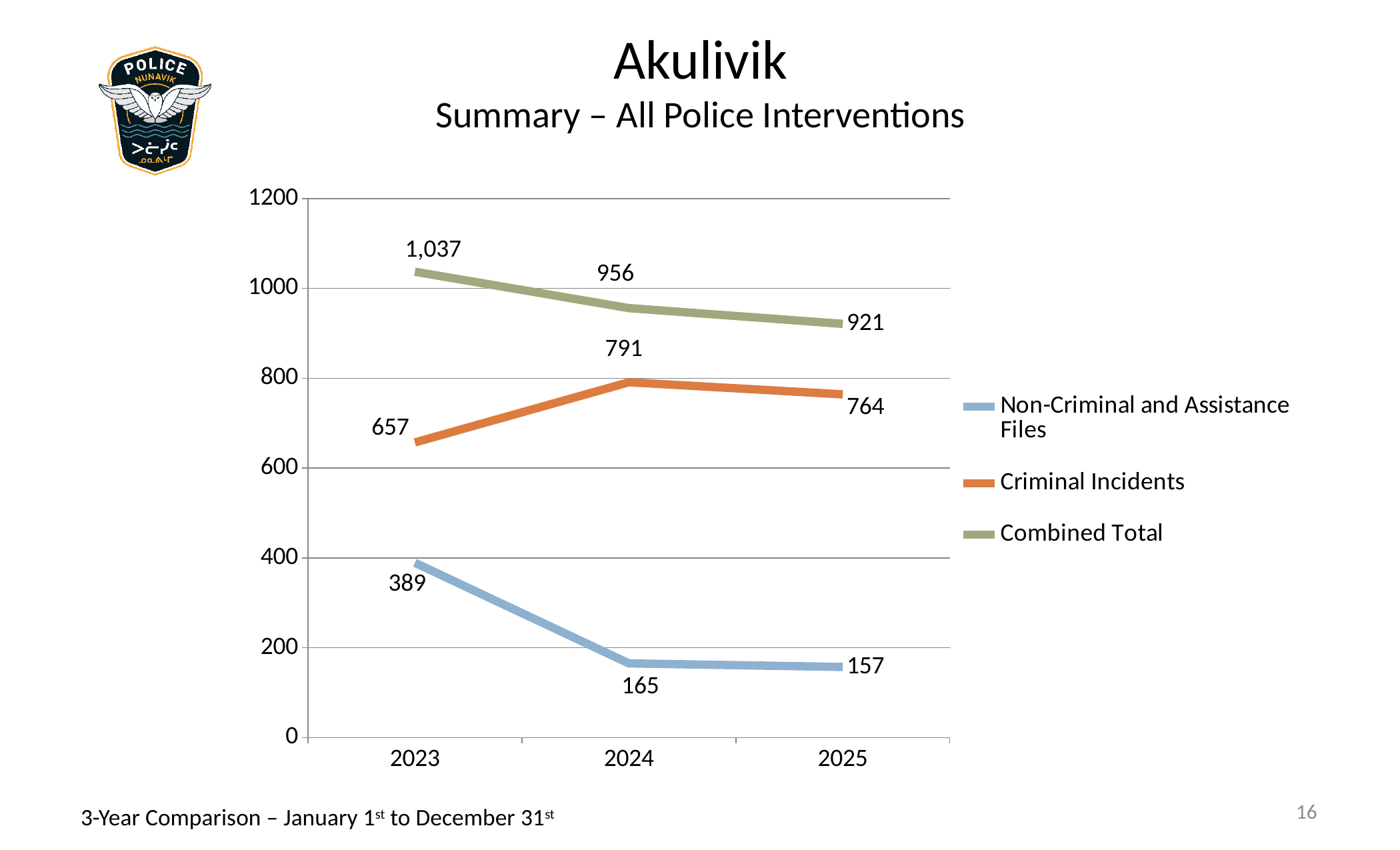
How many series does the legend list? 3 What is the value for Criminal Incidents in 2024? 791 What is the value for Combined Total in 2023? 1,037 Is the value for Non-Criminal and Assistance Files in 2023 greater or less than 200? greater What is the value for Non-Criminal and Assistance Files in 2025? 157 In which year is the value for Non-Criminal and Assistance Files lowest? 2025 What is the difference between the Combined Total in 2023 and in 2025? 116 What kind of chart is shown on the slide? line chart How many years are shown on the x axis? 3 Does the Combined Total rise or fall from 2023 to 2025? fall Which is larger: Criminal Incidents in 2024 or Criminal Incidents in 2023? Criminal Incidents in 2024 In which year is the Combined Total highest? 2023